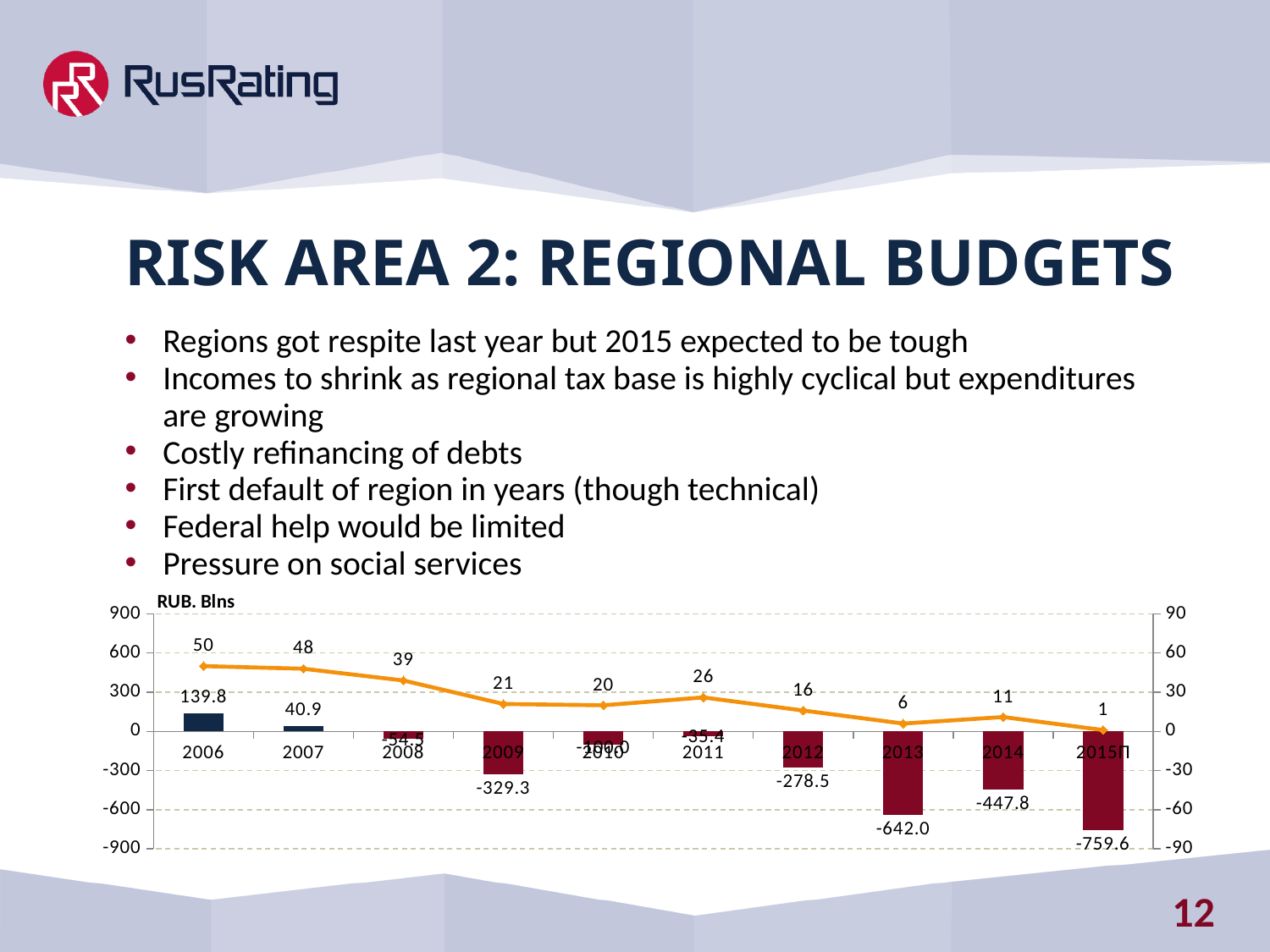
What is the line value for 2006? 50 What is the bar value for 2013? -642.0 Which year has the larger line value, 2011 or 2012? 2011 Which year has the highest bar value? 2006 Does the line rise or fall overall from 2006 to 2015П? fall What is the bar value for 2006? 139.8 What is the bar value for 2015П? -759.6 What is the line value for 2015П? 1 Is the bar value for 2008 greater or less than -300? greater How many years are shown on the x axis? 10 Which year has the lowest bar value? 2015П What is the difference between the bar values for 2014 and 2013? 194.2